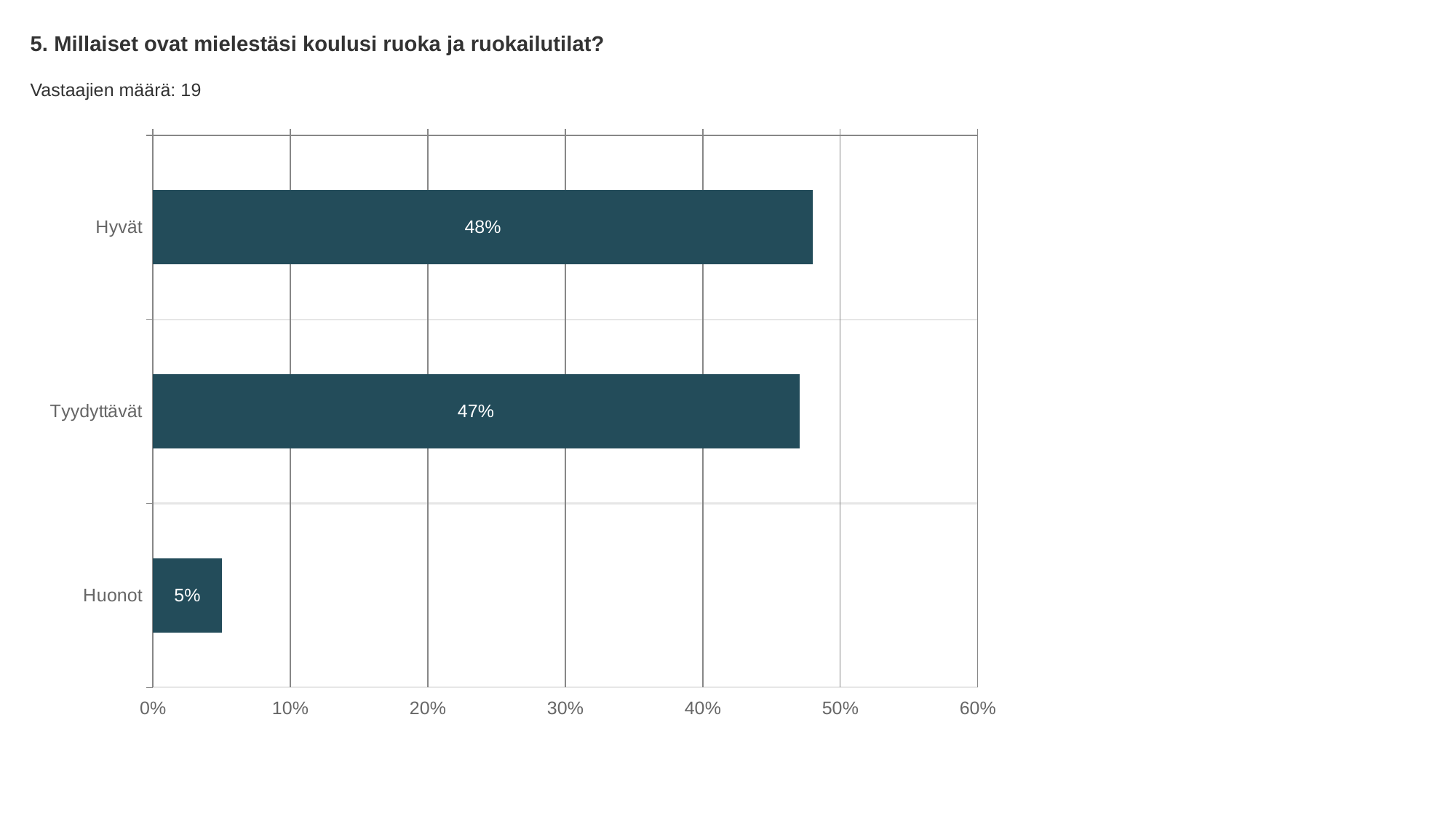
Which is larger, the value for Tyydyttävät or the value for Huonot? Tyydyttävät Is the value for Huonot greater or less than 10%? less What is the value for Huonot? 5% How many respondents (Vastaajien määrä) are stated on the slide? 19 Is the value for Hyvät greater or less than 40%? greater What is the difference between the values for Hyvät and Huonot? 43% What is the value for Tyydyttävät? 47% Which category has the lowest value? Huonot How many categories are shown in the chart? 3 What kind of chart is shown on the slide? bar chart What is the value for Hyvät? 48% What is the difference between the values for Tyydyttävät and Huonot? 42%